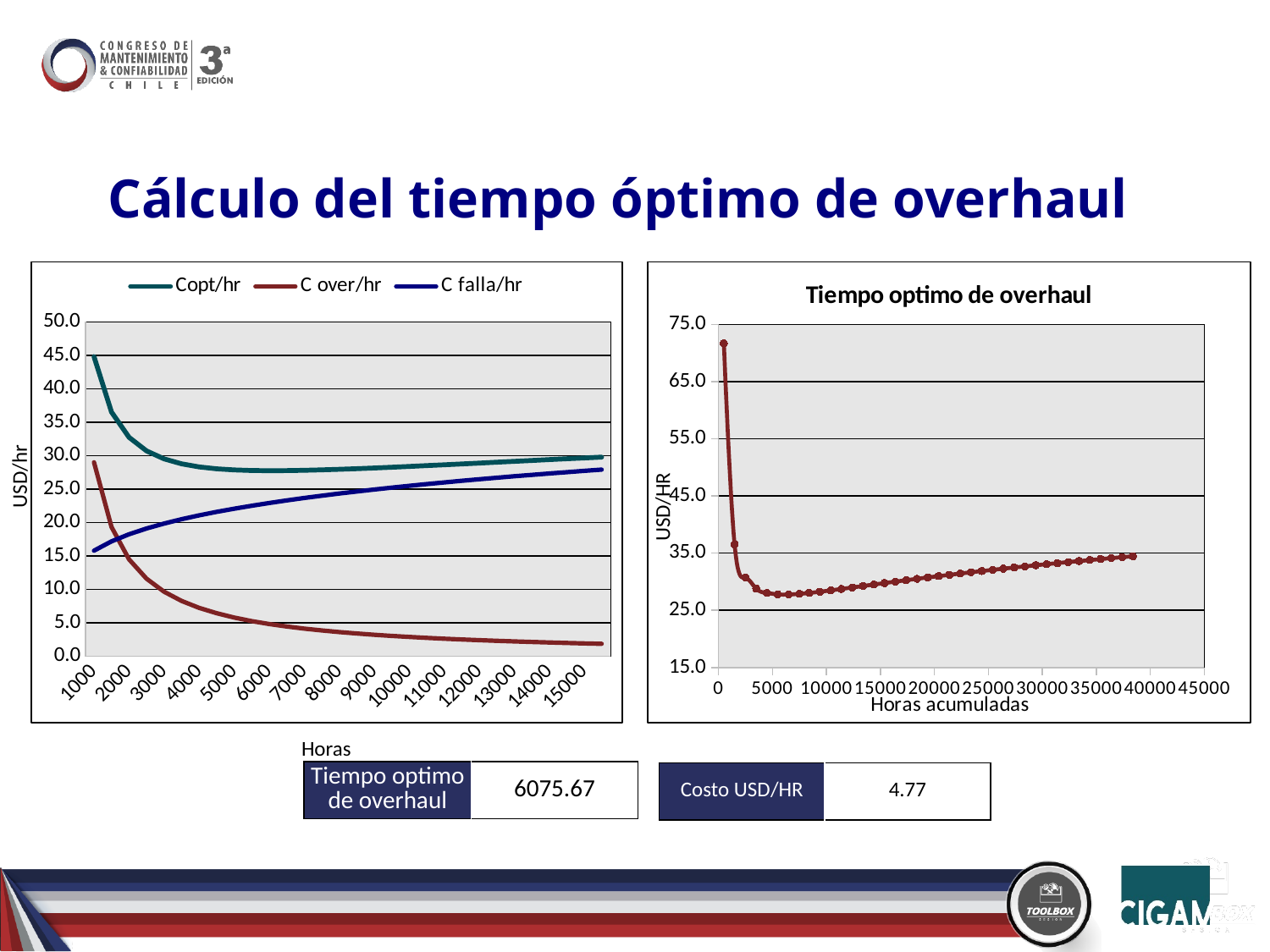
On the right chart 'Tiempo optimo de overhaul', is the first plotted value (near 0 hours) greater or less than 65.0? greater What kind of chart is the left chart? line chart What is the title of the right chart? Tiempo optimo de overhaul On the left chart, how many hour categories are labelled on the x axis? 15 On the left chart, at 15000 hours, which series is higher: C falla/hr or C over/hr? C falla/hr On the right chart 'Tiempo optimo de overhaul', is the lowest plotted value greater or less than 35.0? less On the left chart, is the value of C over/hr at 15000 hours greater or less than 5.0? less On the right chart 'Tiempo optimo de overhaul', what is the x-axis title? Horas acumuladas On the left chart, does the C falla/hr series rise or fall as the hours increase along the x axis? rise On the left chart, how many series does the legend list? 3 On the left chart, does the C over/hr series rise or fall as the hours increase along the x axis? fall